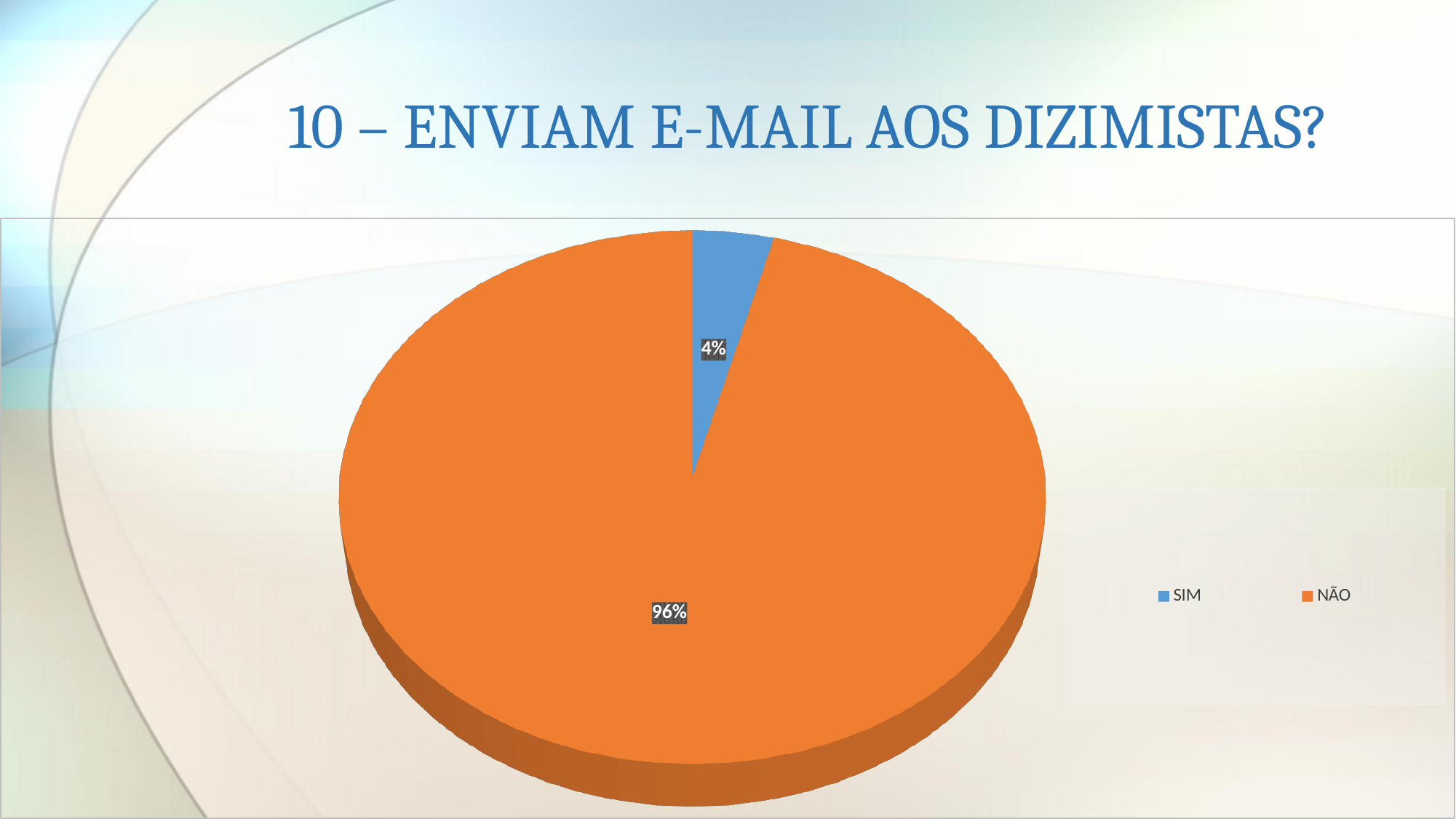
What is the difference in percentage points between the NÃO and SIM slices? 92 What colour is the NÃO slice in the pie chart? Orange What percentage of the pie chart is labelled SIM? 4% Which category has the smallest share of the pie chart? SIM Which slice is larger, SIM or NÃO? NÃO What kind of chart is shown on the slide? Pie chart What is the title of the slide? 10 – ENVIAM E-MAIL AOS DIZIMISTAS? What percentage of the pie chart is labelled NÃO? 96% How many slices does the pie chart have? 2 How many entries does the legend list? 2 Which category has the largest share of the pie chart? NÃO What share of the pie does the SIM slice represent? 4%